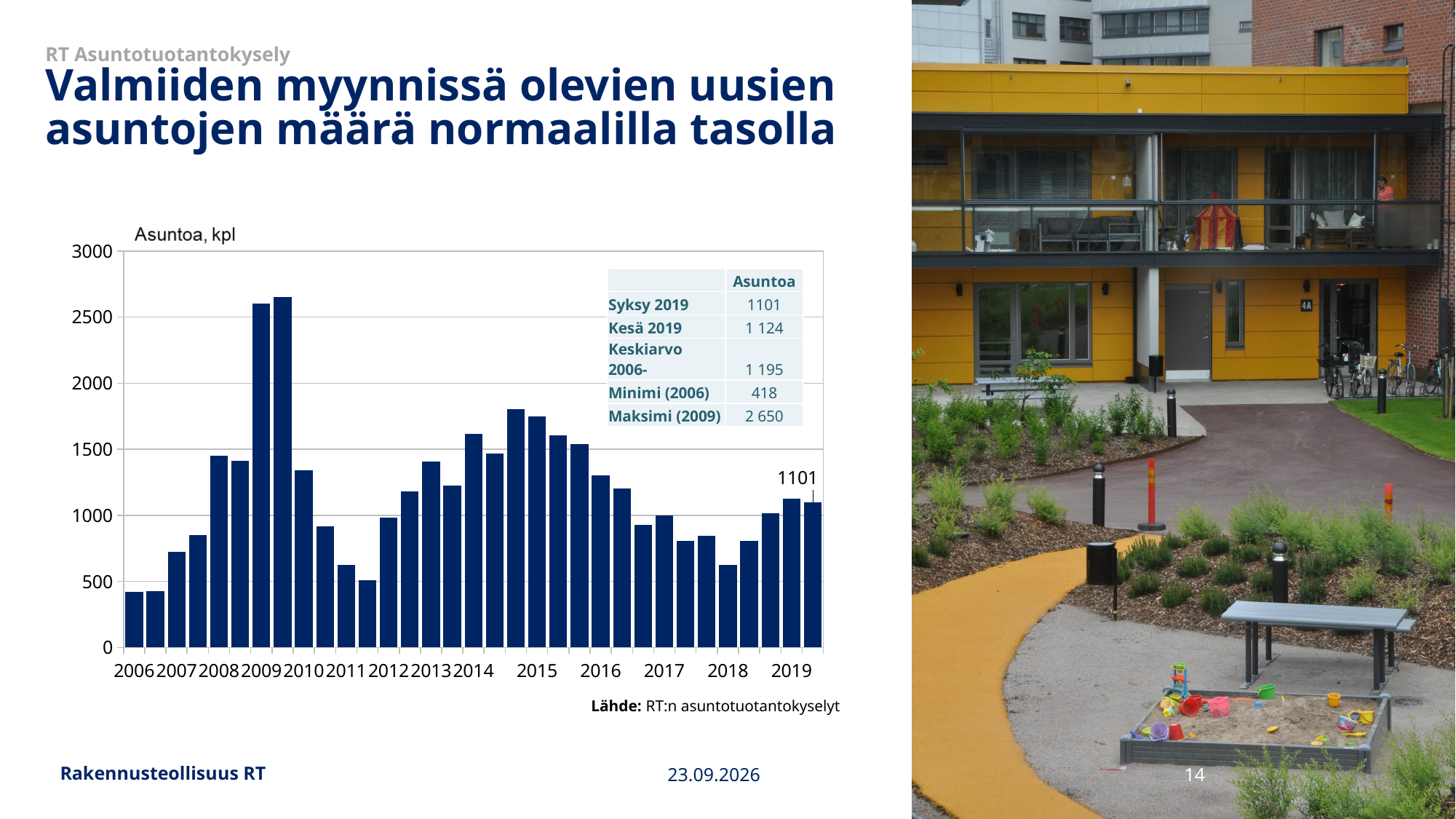
Which year has taller bars, 2009 or 2014? 2009 In which year does the chart reach its highest bar? 2009 What is the difference between the Kesä 2019 value (1 124) and the Syksy 2019 value (1101) in the table? 23 What value is printed as the data label on the last bar (2019)? 1101 According to the table on the chart, what is the value for Keskiarvo 2006-? 1 195 What is the label shown above the vertical axis of the chart? Asuntoa, kpl Are the bars for 2011 greater or less than 1000? less Is the value of the tallest bar in 2009 greater or less than 2500? greater What kind of chart is shown on the slide? bar chart According to the table on the chart, what is the value for Maksimi (2009)? 2 650 Is the value of the first bar in 2006 greater or less than 500? less In which year is the lowest bar on the chart? 2006